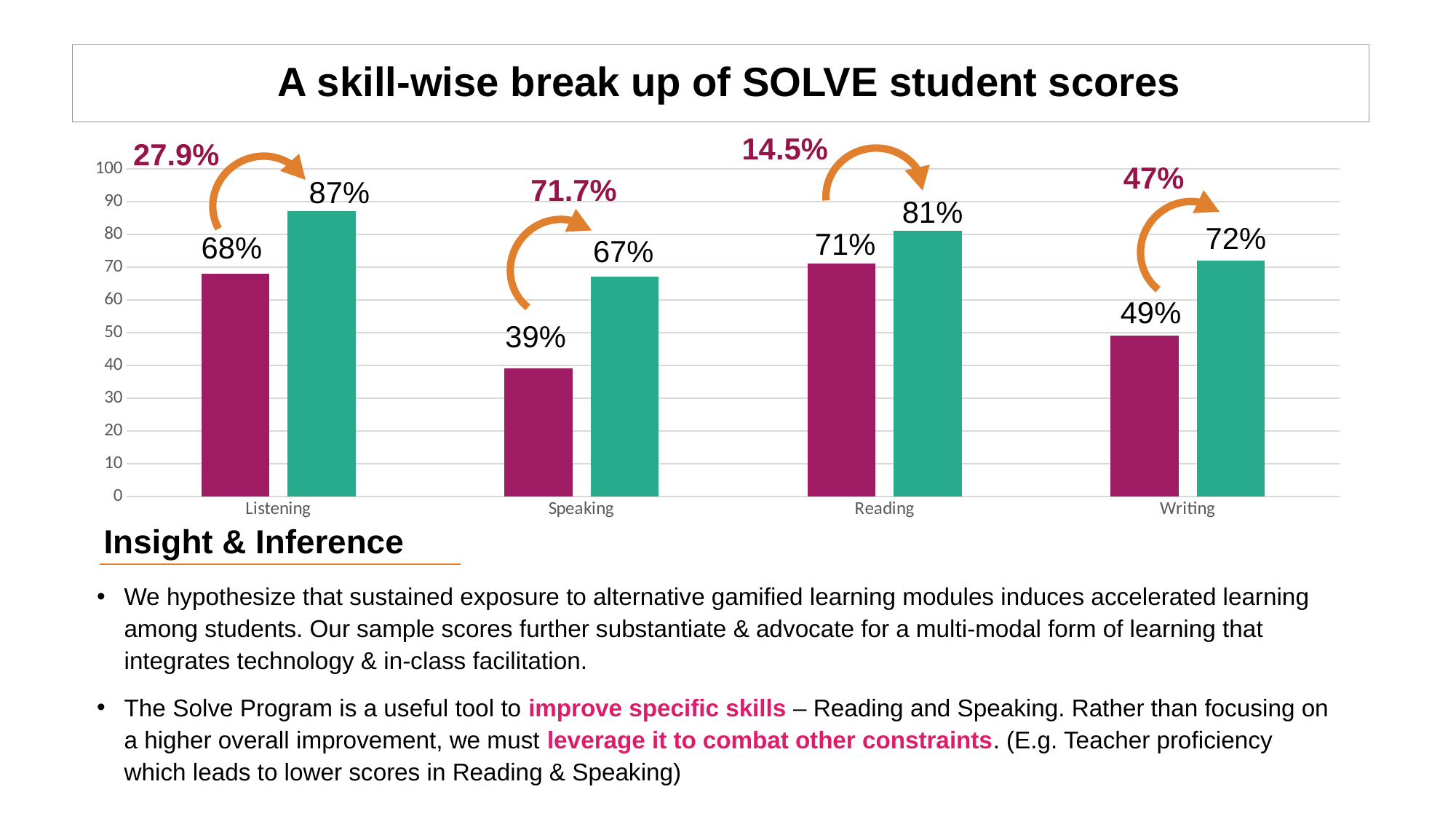
What kind of chart is shown on the slide? bar chart What is the title of the chart? A skill-wise break up of SOLVE student scores Which skill has the highest green bar? Listening Is the magenta bar for Speaking greater or less than 40? less What is the value of the first (magenta) bar for Listening? 68% What is the difference between the green bar and the magenta bar for Writing? 23 percentage points What is the value of the second (green) bar for Speaking? 67% Which skill has the lowest magenta bar? Speaking What percentage improvement is annotated above the Speaking bars? 71.7% How many skill categories are shown on the x axis? 4 What is the value of the green bar for Reading? 81% Which is larger: the green bar for Listening or the green bar for Reading? Listening